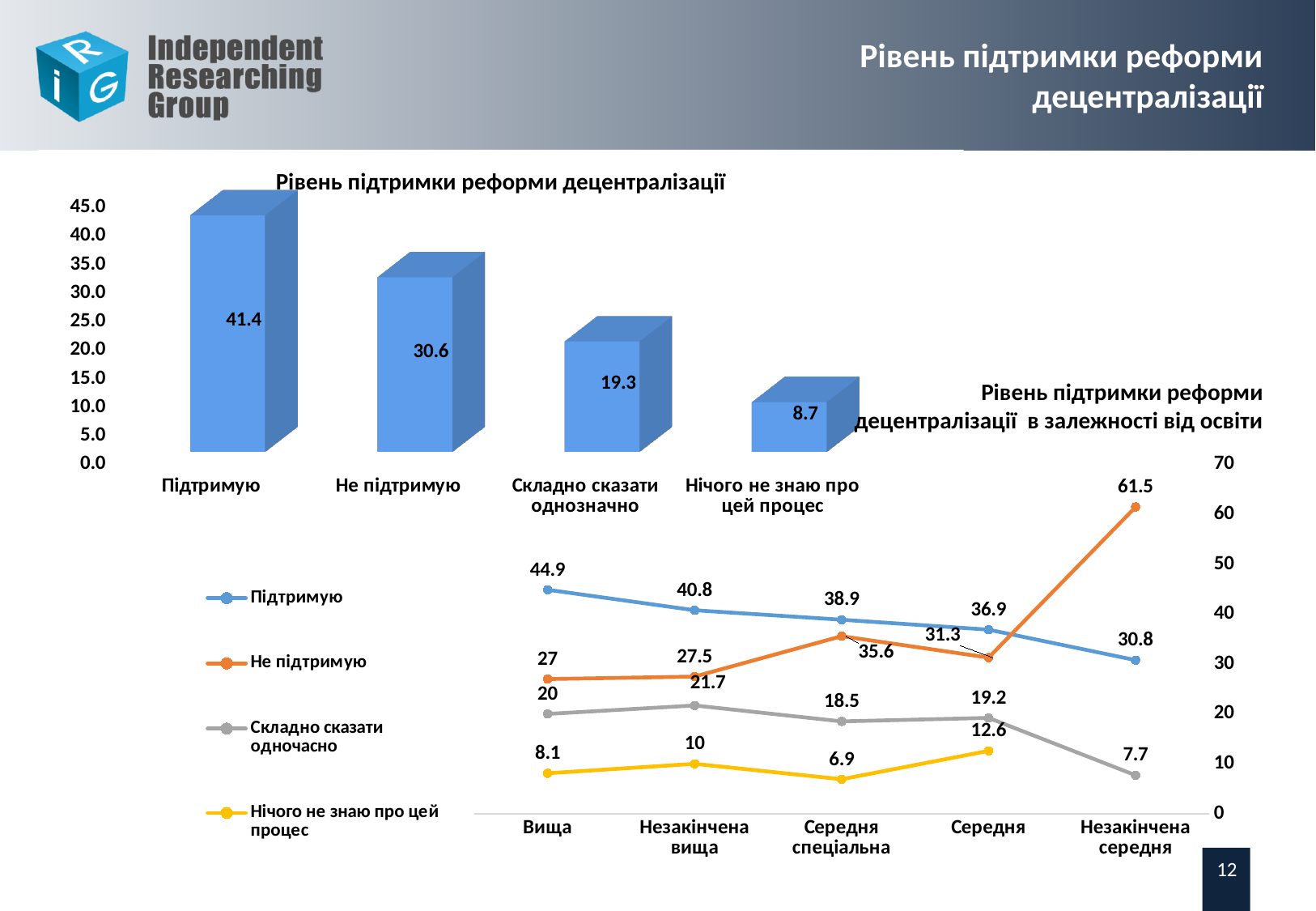
In the line chart 'Рівень підтримки реформи децентралізації в залежності від освіти', what colour is the line for 'Нічого не знаю про цей процес'? Yellow In the bar chart 'Рівень підтримки реформи децентралізації', what is the value for 'Підтримую'? 41.4 In the line chart 'Рівень підтримки реформи децентралізації в залежності від освіти', does the 'Підтримую' series rise or fall from 'Вища' to 'Незакінчена середня'? Fall In the bar chart 'Рівень підтримки реформи децентралізації', what is the difference between 'Підтримую' and 'Не підтримую'? 10.8 In the line chart 'Рівень підтримки реформи децентралізації в залежності від освіти', what is the value of 'Підтримую' for 'Вища'? 44.9 In the line chart 'Рівень підтримки реформи децентралізації в залежності від освіти', how many series does the legend list? 4 What type of chart is the chart at the top left of the slide? Bar chart In the line chart 'Рівень підтримки реформи децентралізації в залежності від освіти', what is the value of 'Не підтримую' for 'Незакінчена середня'? 61.5 In the bar chart 'Рівень підтримки реформи децентралізації', how many categories are shown? 4 In the line chart 'Рівень підтримки реформи децентралізації в залежності від освіти', which is larger for 'Середня спеціальна': 'Підтримую' or 'Не підтримую'? Підтримую In the bar chart 'Рівень підтримки реформи децентралізації', which category has the lowest value? Нічого не знаю про цей процес In the line chart 'Рівень підтримки реформи децентралізації в залежності від освіти', what is the value of 'Складно сказати одночасно' for 'Незакінчена середня'? 7.7